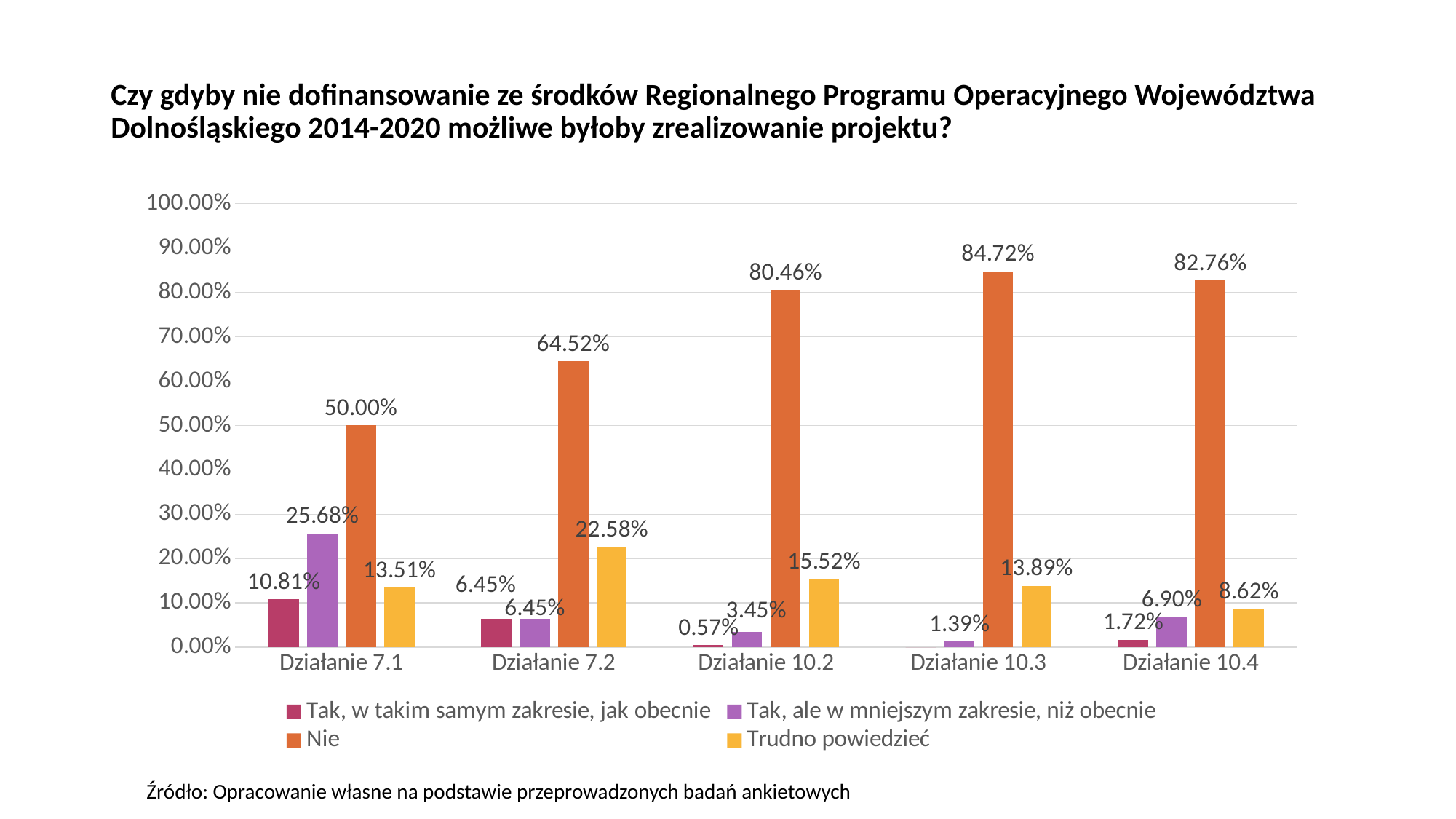
Which category has the highest value for "Nie"? Działanie 10.3 What is the value of "Nie" for Działanie 10.3? 84.72% How many categories are shown on the x axis? 5 Which category has the lowest value for "Nie"? Działanie 7.1 What is the value of "Tak, ale w mniejszym zakresie, niż obecnie" for Działanie 7.1? 25.68% What is the value of "Tak, w takim samym zakresie, jak obecnie" for Działanie 10.4? 1.72% What is the difference between the "Nie" values for Działanie 10.4 and Działanie 7.2? 18.24% What is the value of "Trudno powiedzieć" for Działanie 7.2? 22.58% How many series does the legend list? 4 Is the value of "Nie" for Działanie 7.2 greater or less than 60.00%? greater Which is larger: "Trudno powiedzieć" for Działanie 10.2 or for Działanie 10.4? Działanie 10.2 What kind of chart is shown on the slide? Bar chart